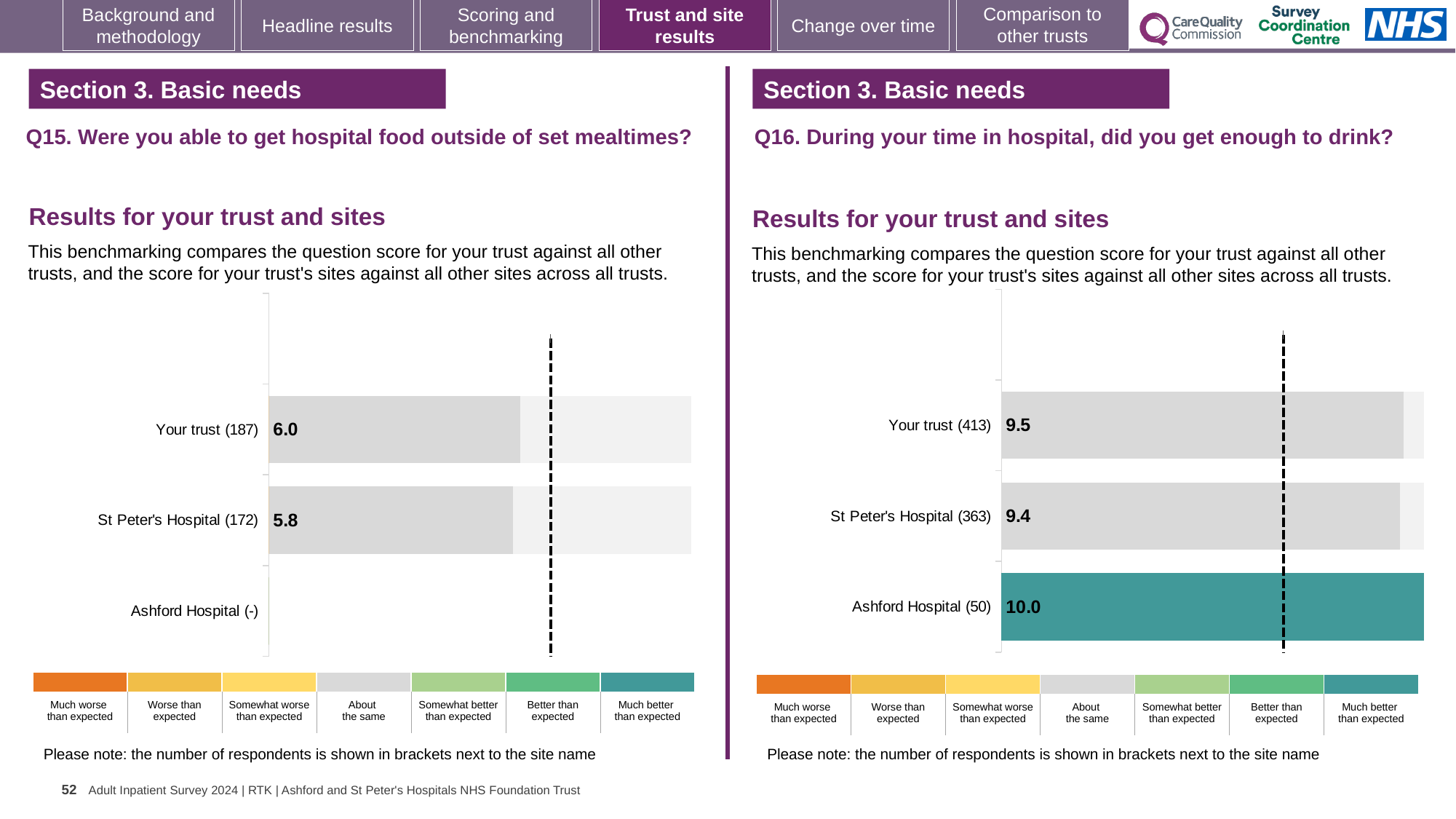
In the Q16 chart (enough to drink), which benchmark category does the colour of the Ashford Hospital bar correspond to? Much better than expected How many respondents are shown in brackets for Your trust in the Q16 chart (enough to drink)? 413 In the Q15 chart (hospital food outside of set mealtimes), what is the score for St Peter's Hospital? 5.8 In the Q16 chart (enough to drink), what is the score for Ashford Hospital? 10.0 In the Q16 chart (enough to drink), what is the difference between the scores for Ashford Hospital and St Peter's Hospital? 0.6 In the Q15 chart (hospital food outside of set mealtimes), what is the score for Your trust? 6.0 In the Q16 chart (enough to drink), what is the score for St Peter's Hospital? 9.4 In the Q15 chart (hospital food outside of set mealtimes), what is the difference between the scores for Your trust and St Peter's Hospital? 0.2 What type of chart is used in the Q15 chart (hospital food outside of set mealtimes)? Bar chart In the Q16 chart (enough to drink), which site or trust has the highest score? Ashford Hospital In the Q16 chart (enough to drink), which site or trust has the lowest score? St Peter's Hospital In the Q15 chart (hospital food outside of set mealtimes), which has the larger score, Your trust or St Peter's Hospital? Your trust